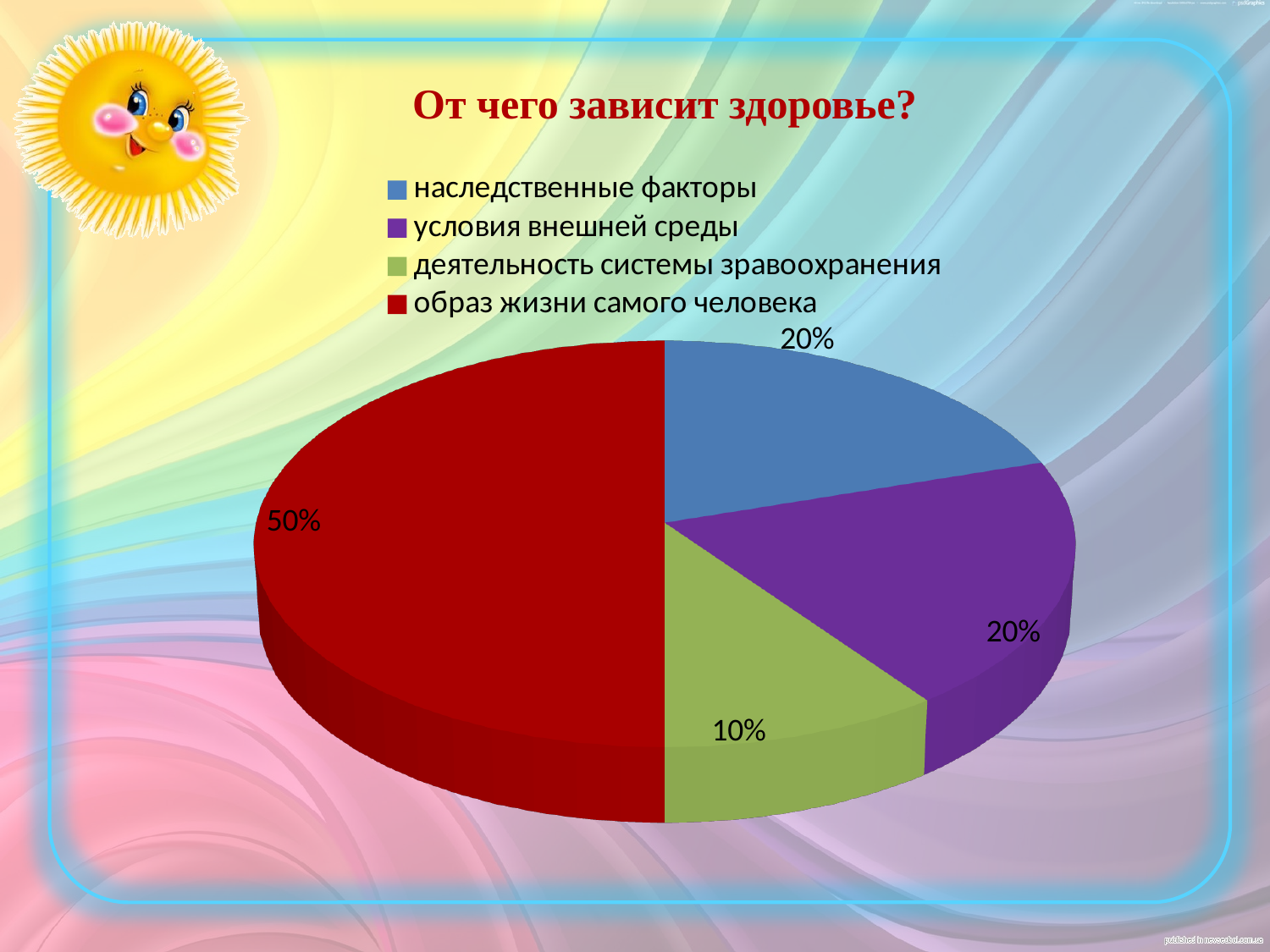
What is the value for "условия внешней среды"? 20% What share of the pie is "деятельность системы зравоохранения"? 10% What is the title of the chart? От чего зависит здоровье? What is the difference between the share for "образ жизни самого человека" and the share for "деятельность системы зравоохранения"? 40% Which category has the smallest slice of the pie? деятельность системы зравоохранения What is the value for "наследственные факторы"? 20% Which category has the largest slice of the pie? образ жизни самого человека What kind of chart is shown on the slide? pie chart Which is larger: the share for "наследственные факторы" or the share for "деятельность системы зравоохранения"? наследственные факторы How many categories does the pie chart have? 4 What colour is the slice for "образ жизни самого человека"? red What share of the pie is "образ жизни самого человека"? 50%